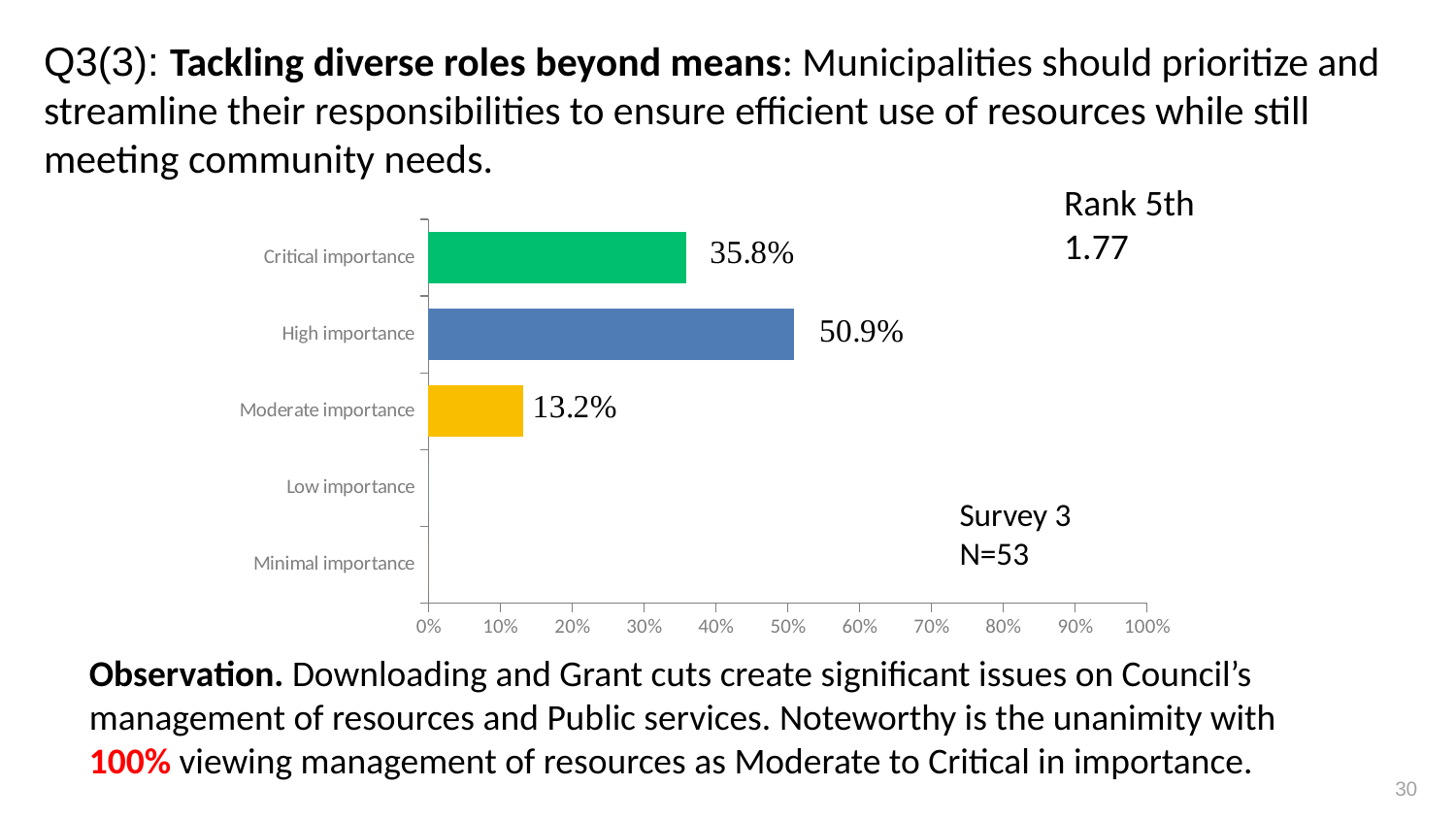
Which importance category has the highest percentage? High importance What is the difference between the High importance and Critical importance percentages? 15.1% How many importance categories are listed on the vertical axis? 5 What is the difference between the Critical importance and Moderate importance percentages? 22.6% What colour is the bar for High importance? Blue What percentage of respondents rated this as High importance? 50.9% Is the value for Moderate importance greater or less than 20%? less Is the value for High importance greater or less than 50%? greater What kind of chart is shown on the slide? Bar chart What percentage of respondents rated this as Critical importance? 35.8% Which category has the larger value, Critical importance or Moderate importance? Critical importance What percentage of respondents rated this as Moderate importance? 13.2%